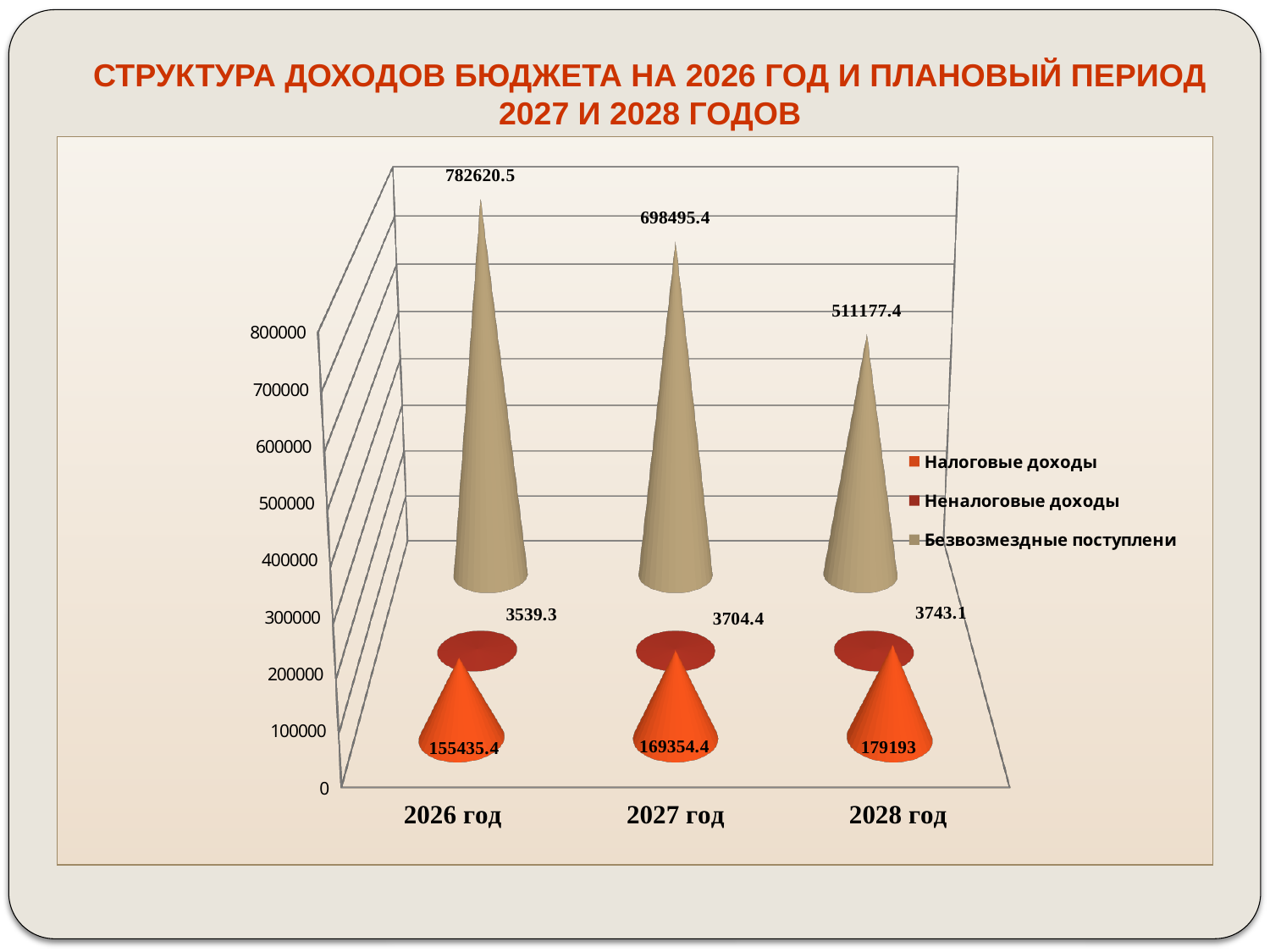
How many series does the legend list? 3 How many years are shown on the x axis? 3 What is the value of Безвозмездные поступления for 2026 год? 782620.5 In which year is Безвозмездные поступления the highest? 2026 год In which year is Налоговые доходы the lowest? 2026 год What is the difference between Налоговые доходы in 2028 год and 2026 год? 23757.6 Do the values of Безвозмездные поступления rise or fall from 2026 год to 2028 год? fall Which is larger in 2027 год: Налоговые доходы or Безвозмездные поступления? Безвозмездные поступления Is the value of Безвозмездные поступления for 2028 год greater or less than 600000? less What is the difference between Безвозмездные поступления in 2026 год and 2027 год? 84125.1 What is the value of Налоговые доходы for 2028 год? 179193 What is the value of Неналоговые доходы for 2027 год? 3704.4